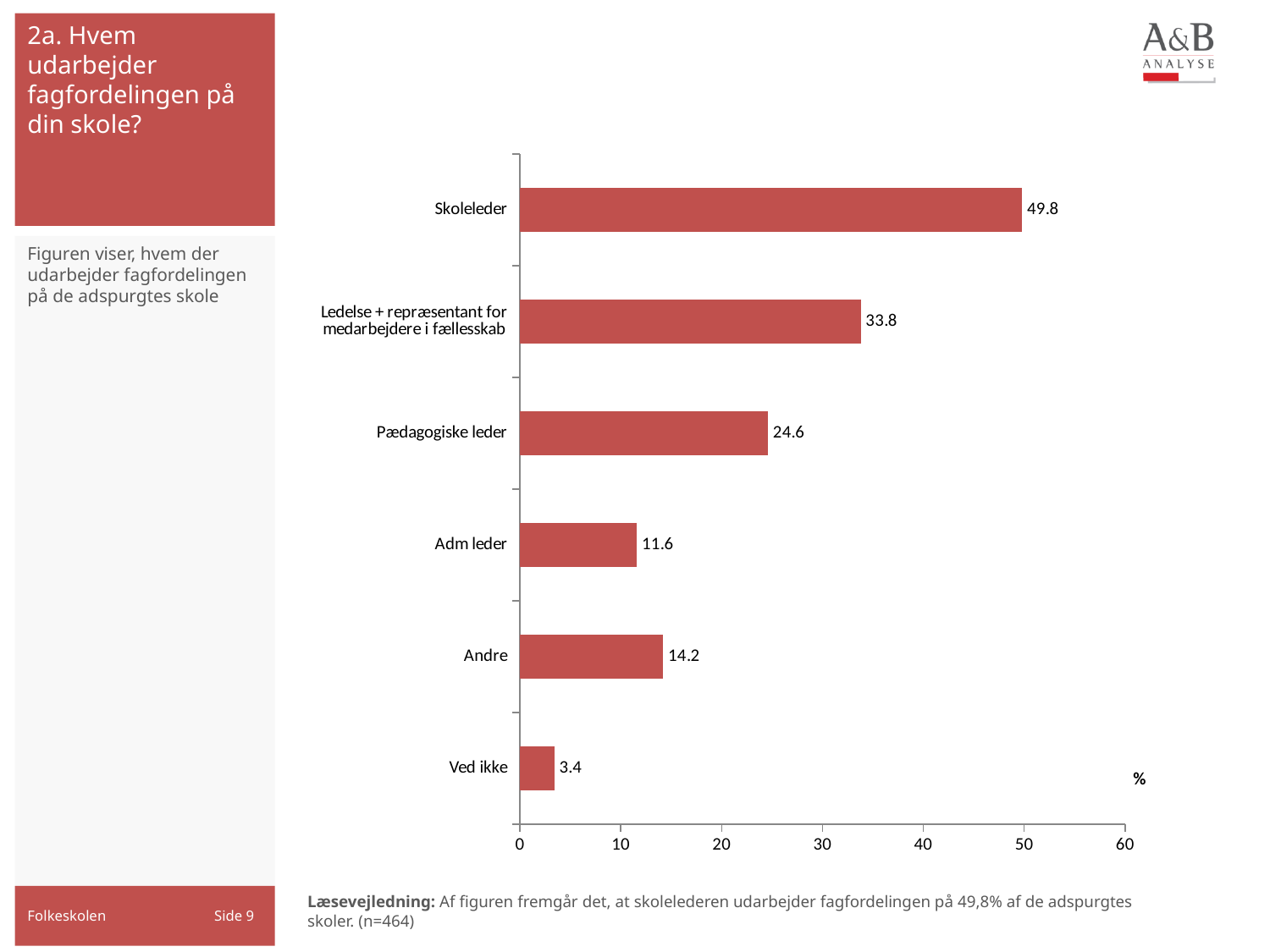
What kind of chart is shown on the slide? bar chart What is the value for Pædagogiske leder? 24.6 Which category has the lowest value? Ved ikke What is the value for Skoleleder? 49.8 How many categories are shown in the chart? 6 What is the value for Ved ikke? 3.4 What is the value for Ledelse + repræsentant for medarbejdere i fællesskab? 33.8 Is the value for Ledelse + repræsentant for medarbejdere i fællesskab greater or less than 30? greater What is the difference between the values for Skoleleder and Pædagogiske leder? 25.2 Which is larger, the value for Andre or the value for Adm leder? Andre Which category has the highest value? Skoleleder What is the maximum value shown on the horizontal axis? 60